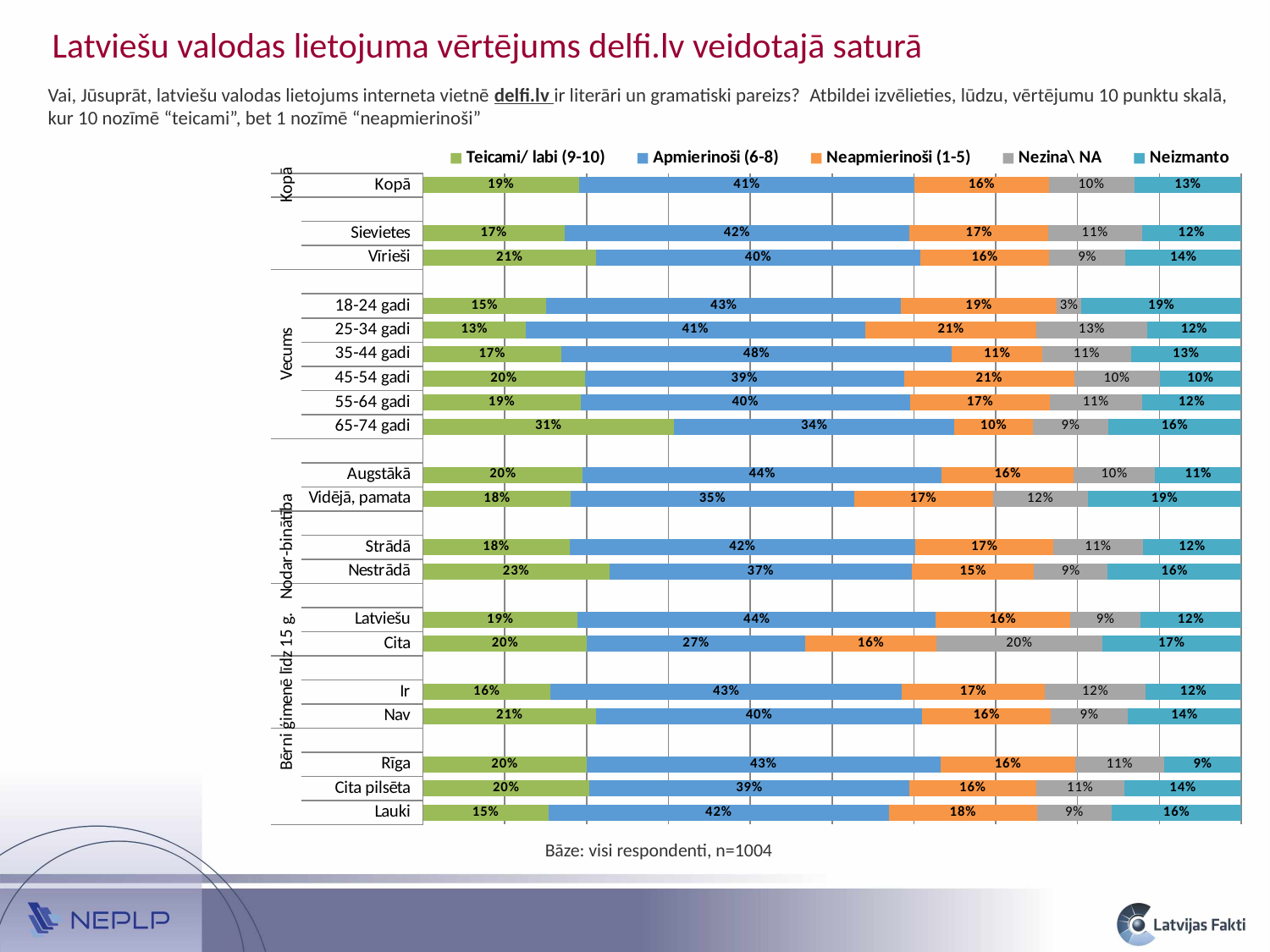
What is the difference between the "Teicami/ labi (9-10)" values for Vīrieši and Sievietes? 4% What is the base (n) stated below the chart? n=1004 How many categories are plotted in the chart? 20 Which category has the highest "Apmierinoši (6-8)" value? 35-44 gadi What kind of chart is shown on the slide? Stacked bar chart What is the "Apmierinoši (6-8)" value for Kopā? 41% How many series does the legend list? 5 Which has a larger "Neapmierinoši (1-5)" value, 25-34 gadi or 35-44 gadi? 25-34 gadi Which category has the lowest "Nezina\ NA" value? 18-24 gadi Which category has the lowest "Apmierinoši (6-8)" value? Cita What is the "Teicami/ labi (9-10)" value for 65-74 gadi? 31% What is the "Neizmanto" value for Rīga? 9%